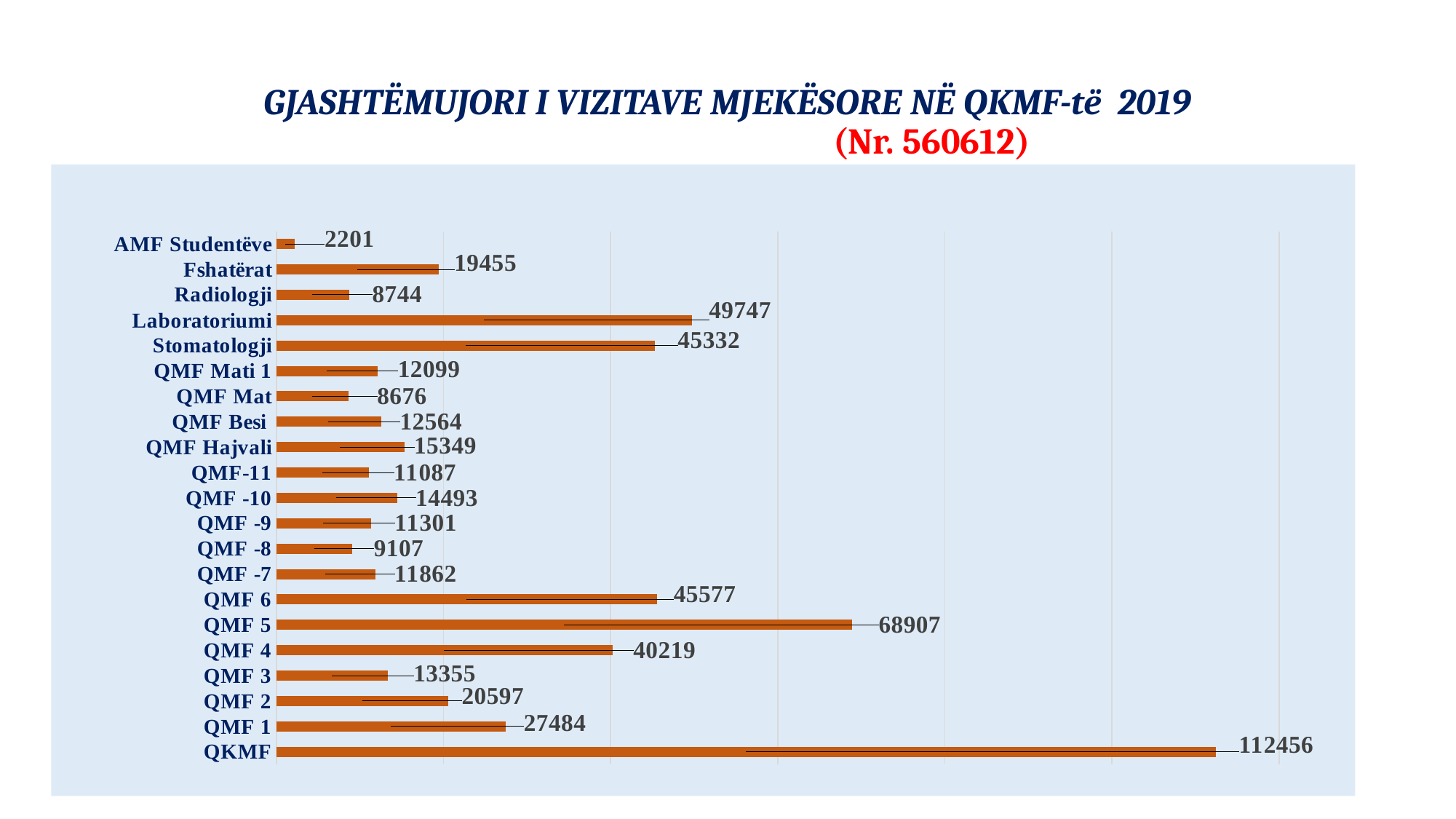
Which category has the lowest value? AMF Studentëve What is the difference between the values for QMF 1 and QMF 2? 6887 What is the value for Fshatërat? 19455 What is the value for QMF Hajvali? 15349 How many categories are shown in the chart? 21 What is the value for QKMF? 112456 Which has a larger value, QMF 4 or QMF 3? QMF 4 What is the difference between the values for QKMF and QMF 5? 43549 What is the value for Laboratoriumi? 49747 What kind of chart is shown on the slide? Bar chart Which category has the highest value? QKMF Which has a larger value, Radiologji or Fshatërat? Fshatërat